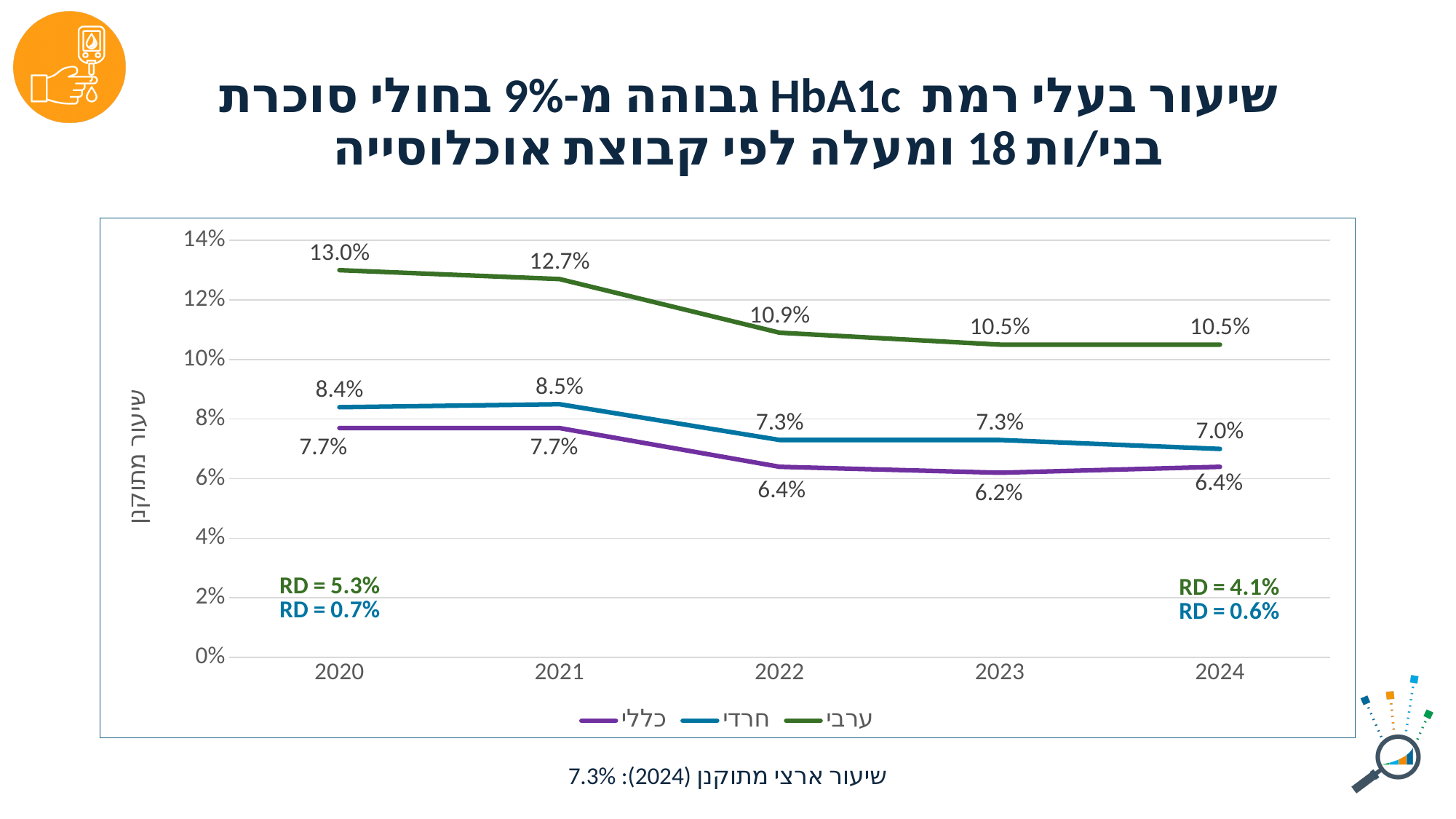
What is the value for the חרדי series in 2024? 7.0% Does the ערבי series rise or fall from 2020 to 2024? Fall What is the difference between the ערבי and כללי values in 2024? 4.1% Which series has the larger value in 2021, חרדי or כללי? חרדי What colour is the line for the ערבי series? Green What is the value for the ערבי series in 2020? 13.0% In which year is the כללי series at its lowest? 2023 In which year is the ערבי series at its highest? 2020 What is the value for the כללי series in 2023? 6.2% How many years are shown on the x axis? 5 How many series does the legend list? 3 What type of chart is shown on the slide? Line chart